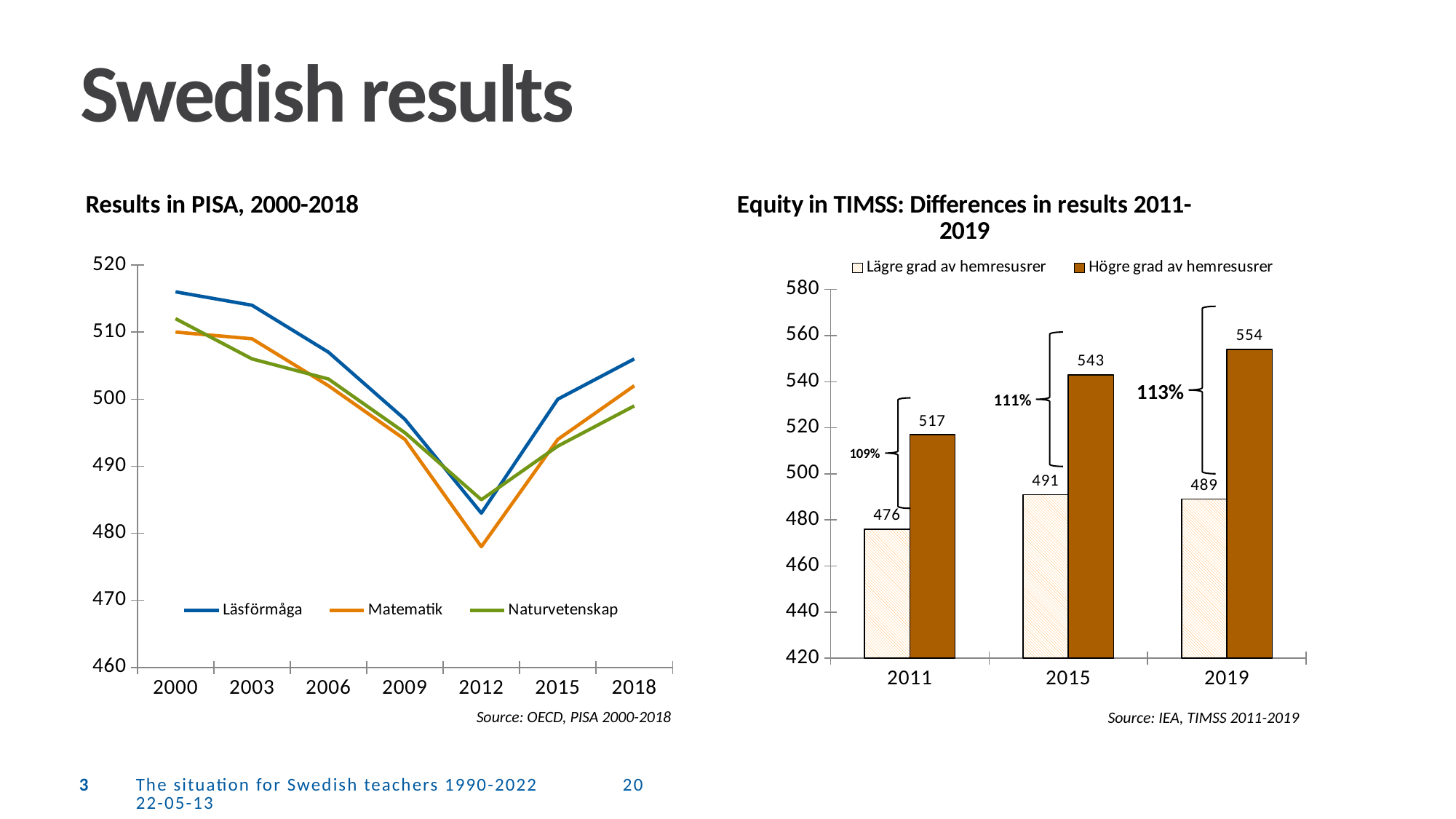
In the 'Equity in TIMSS' chart, what kind of chart is it? Bar chart In the 'Equity in TIMSS' chart, which year has the highest value for Högre grad av hemresusrer? 2019 In the 'Equity in TIMSS' chart, which is larger: Lägre grad av hemresusrer in 2015 or in 2011? 2015 In the 'Results in PISA, 2000-2018' chart, is the value for Läsförmåga in 2000 greater or less than 510? greater In the 'Results in PISA, 2000-2018' chart, do the values for Matematik rise or fall between 2012 and 2018? Rise In the 'Equity in TIMSS' chart, what is the value for Högre grad av hemresusrer in 2019? 554 In the 'Results in PISA, 2000-2018' chart, how many years are plotted on the x axis? 7 In the 'Results in PISA, 2000-2018' chart, what kind of chart is it? Line chart In the 'Equity in TIMSS' chart, what is the value for Lägre grad av hemresusrer in 2011? 476 In the 'Results in PISA, 2000-2018' chart, in which year does Läsförmåga reach its lowest value? 2012 In the 'Equity in TIMSS' chart, what is the difference between Högre grad av hemresusrer and Lägre grad av hemresusrer in 2015? 52 In the 'Results in PISA, 2000-2018' chart, how many series does the legend list? 3